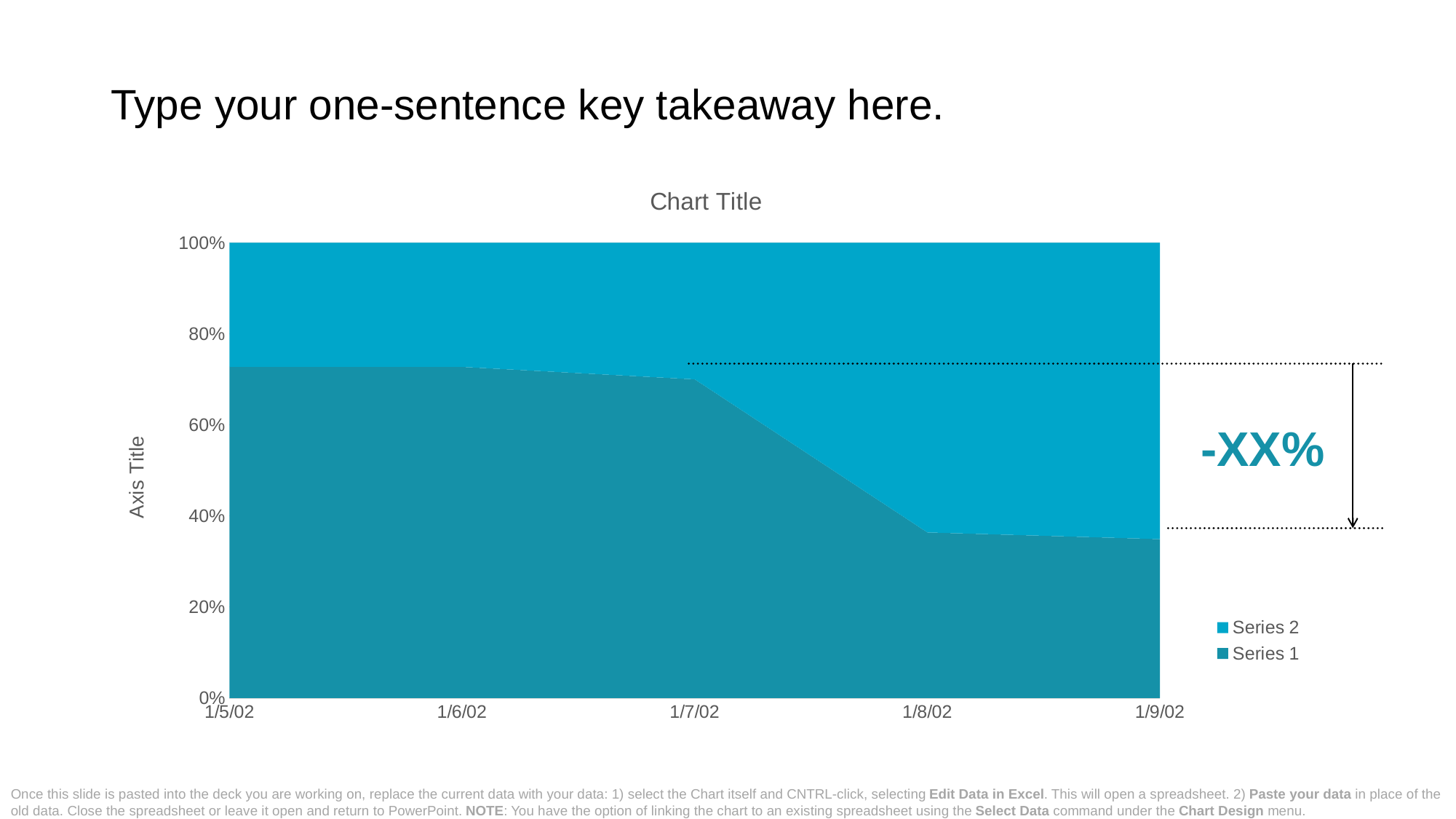
Which is larger for Series 1: the value on 1/5/02 or the value on 1/8/02? 1/5/02 Is the value for Series 1 on 1/9/02 greater or less than 40%? less Does the Series 1 share rise or fall from 1/5/02 to 1/9/02? Fall Is the value for Series 1 on 1/5/02 greater or less than 60%? greater How many series does the legend list? 2 Is the value for Series 1 on 1/7/02 greater or less than 60%? greater What text is shown in the annotation to the right of the chart? -XX% What kind of chart is shown on the slide? Area chart How many dates are shown along the x axis? 5 What is the title of the chart? Chart Title